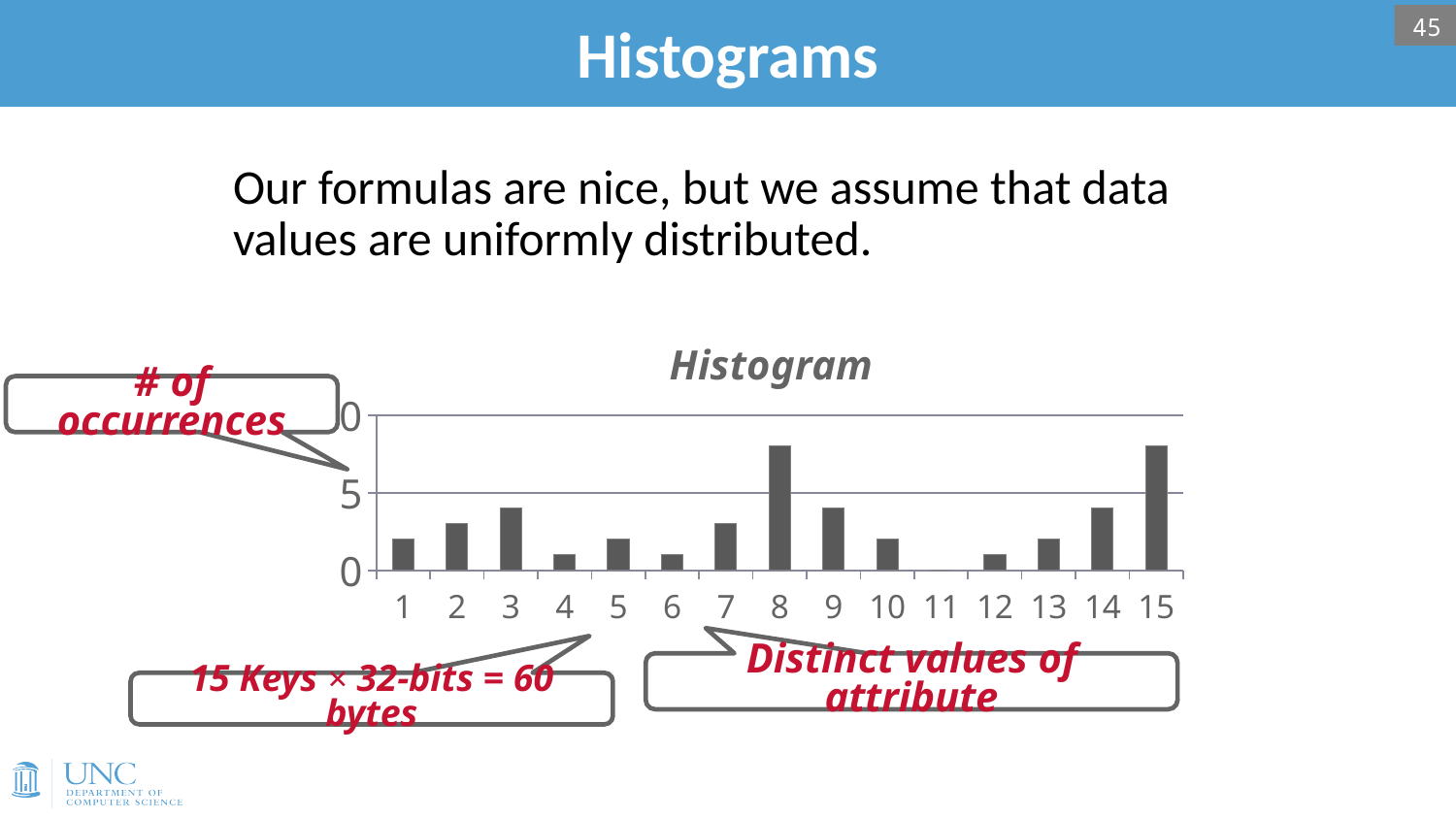
Is the value for category 15 greater or less than 5? greater Is the value for category 3 greater or less than 5? less How many categories are shown on the x axis of the chart? 15 What does the red callout say the x axis represents? Distinct values of attribute What is the title of the chart? Histogram Which has the larger value, category 3 or category 4? category 3 Which has the larger value, category 14 or category 12? category 14 Is the value for category 8 greater or less than 5? greater What kind of chart is shown on the slide? bar chart Which category has the lowest value in the chart? 11 Which has the larger value, category 8 or category 3? category 8